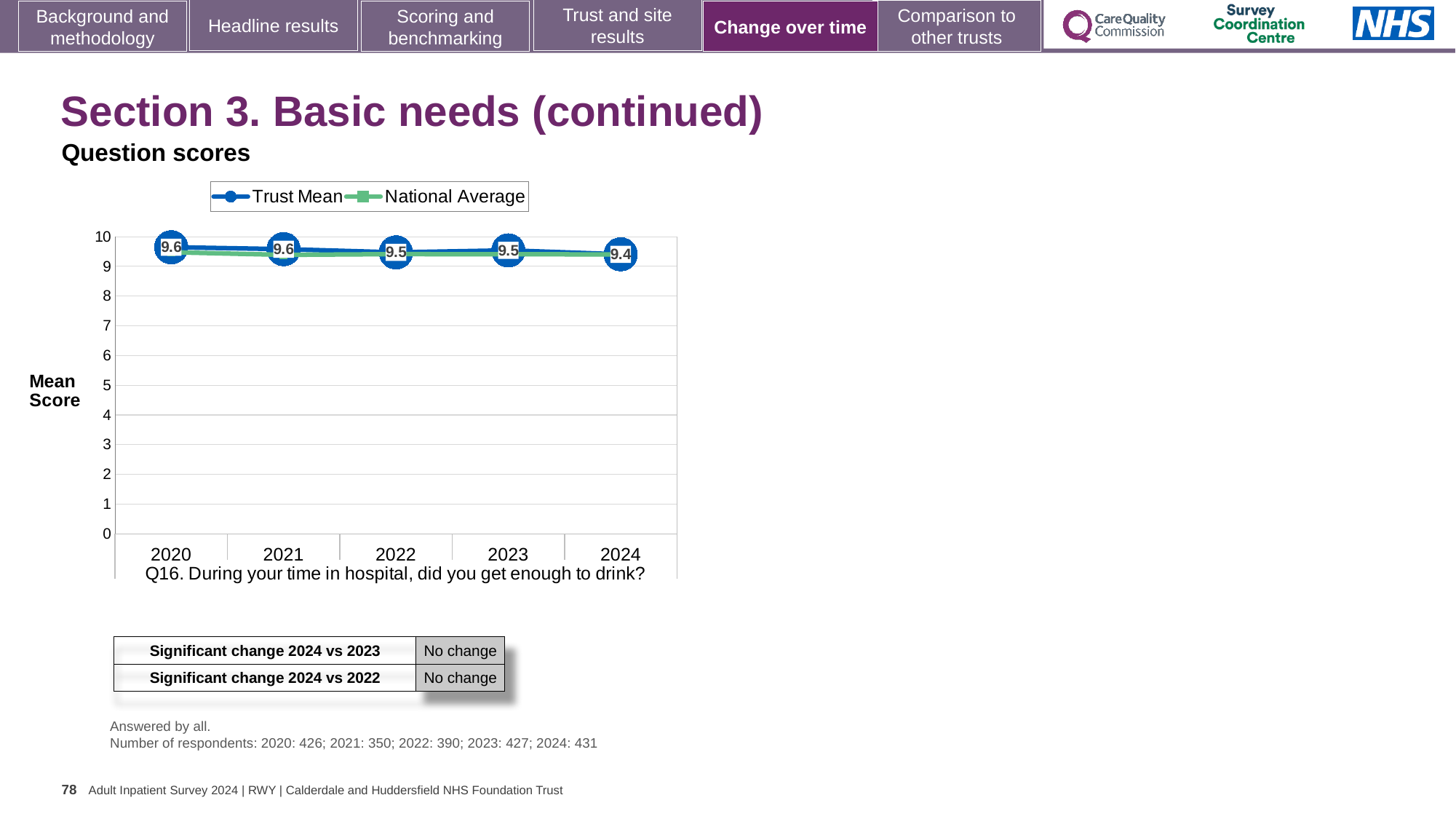
How many years are shown on the x axis? 5 In which year is the Trust Mean score lowest? 2024 Is the National Average value for 2023 greater or less than 9? greater Is the Trust Mean score for 2021 larger or smaller than the Trust Mean score for 2024? larger What is the Trust Mean score for 2020? 9.6 Does the Trust Mean score rise or fall from 2020 to 2024? fall How many series does the legend list? 2 What is the Trust Mean score for 2022? 9.5 Which survey question does the chart relate to? Q16. During your time in hospital, did you get enough to drink? What is the Trust Mean score for 2024? 9.4 What kind of chart is shown on the slide? line chart What is the difference between the Trust Mean score in 2020 and in 2024? 0.2